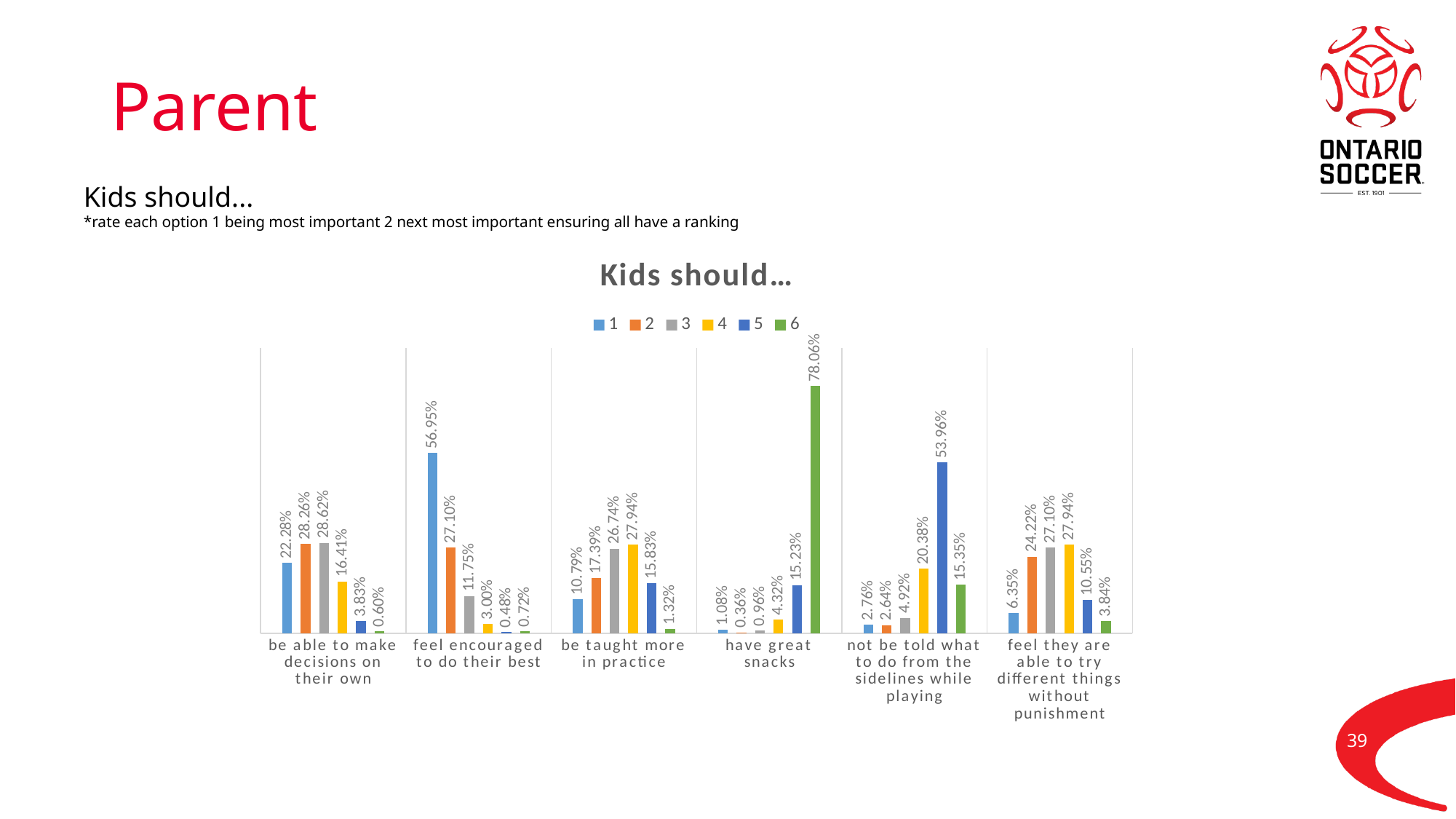
What percentage of parents ranked "feel encouraged to do their best" as 1? 56.95% What is the title of the chart? Kids should… How many series does the legend list? 6 What is the value for series 6 in the "have great snacks" category? 78.06% Which category has the highest value for series 1? feel encouraged to do their best What kind of chart is shown on the slide? bar chart What is the difference between the series 1 value for "feel encouraged to do their best" and the series 1 value for "be able to make decisions on their own"? 34.67% Which is larger: the series 2 value for "feel they are able to try different things without punishment" or the series 2 value for "be taught more in practice"? feel they are able to try different things without punishment How many categories are shown on the x axis? 6 What is the value for series 5 in the "not be told what to do from the sidelines while playing" category? 53.96% What is the value for series 4 in the "be taught more in practice" category? 27.94% Which category has the lowest value for series 6? be able to make decisions on their own